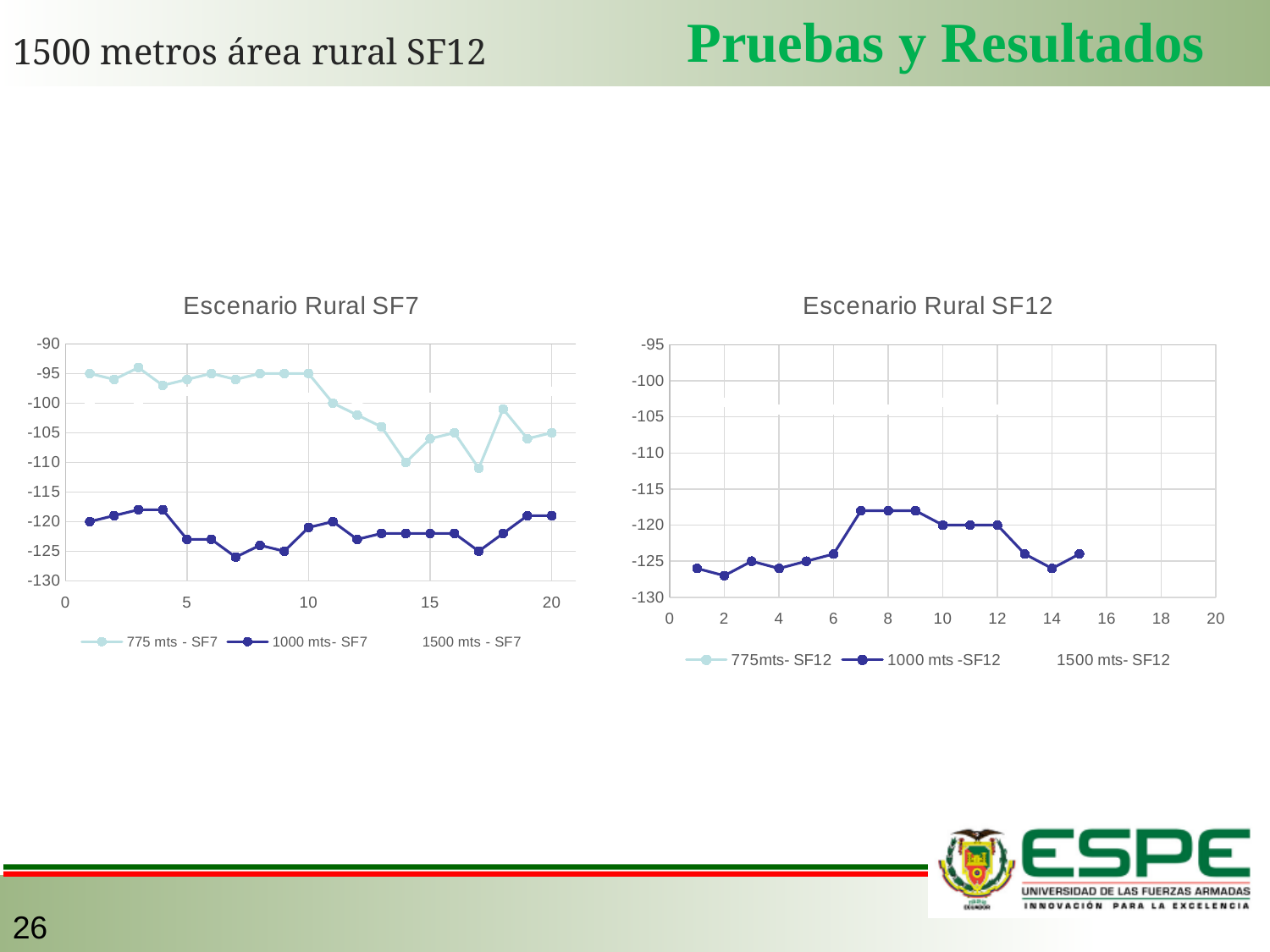
How many series does the legend of the 'Escenario Rural SF12' chart list? 3 In the 'Escenario Rural SF12' chart, how many data points does the '1000 mts -SF12' series have? 15 In the 'Escenario Rural SF12' chart, is the value of the '1000 mts -SF12' series at x = 8 greater or less than -120? greater In the 'Escenario Rural SF7' chart, how many data points does the '1000 mts- SF7' series have? 20 In the 'Escenario Rural SF12' chart, what is the value of the '1000 mts -SF12' series at x = 10? -120 In the 'Escenario Rural SF12' chart, at which x value does the '1000 mts -SF12' series reach its lowest point? 2 In the 'Escenario Rural SF7' chart, is the value of the '775 mts - SF7' series at x = 17 greater or less than -105? less What kind of chart is the 'Escenario Rural SF7' chart? line chart In the 'Escenario Rural SF7' chart, what is the value of the '1000 mts- SF7' series at x = 1? -120 In the 'Escenario Rural SF7' chart, what is the value of the '775 mts - SF7' series at x = 1? -95 In the 'Escenario Rural SF7' chart, which series has higher values, '775 mts - SF7' or '1000 mts- SF7'? 775 mts - SF7 In the 'Escenario Rural SF12' chart, does the '1000 mts -SF12' series rise or fall between x = 2 and x = 7? rise